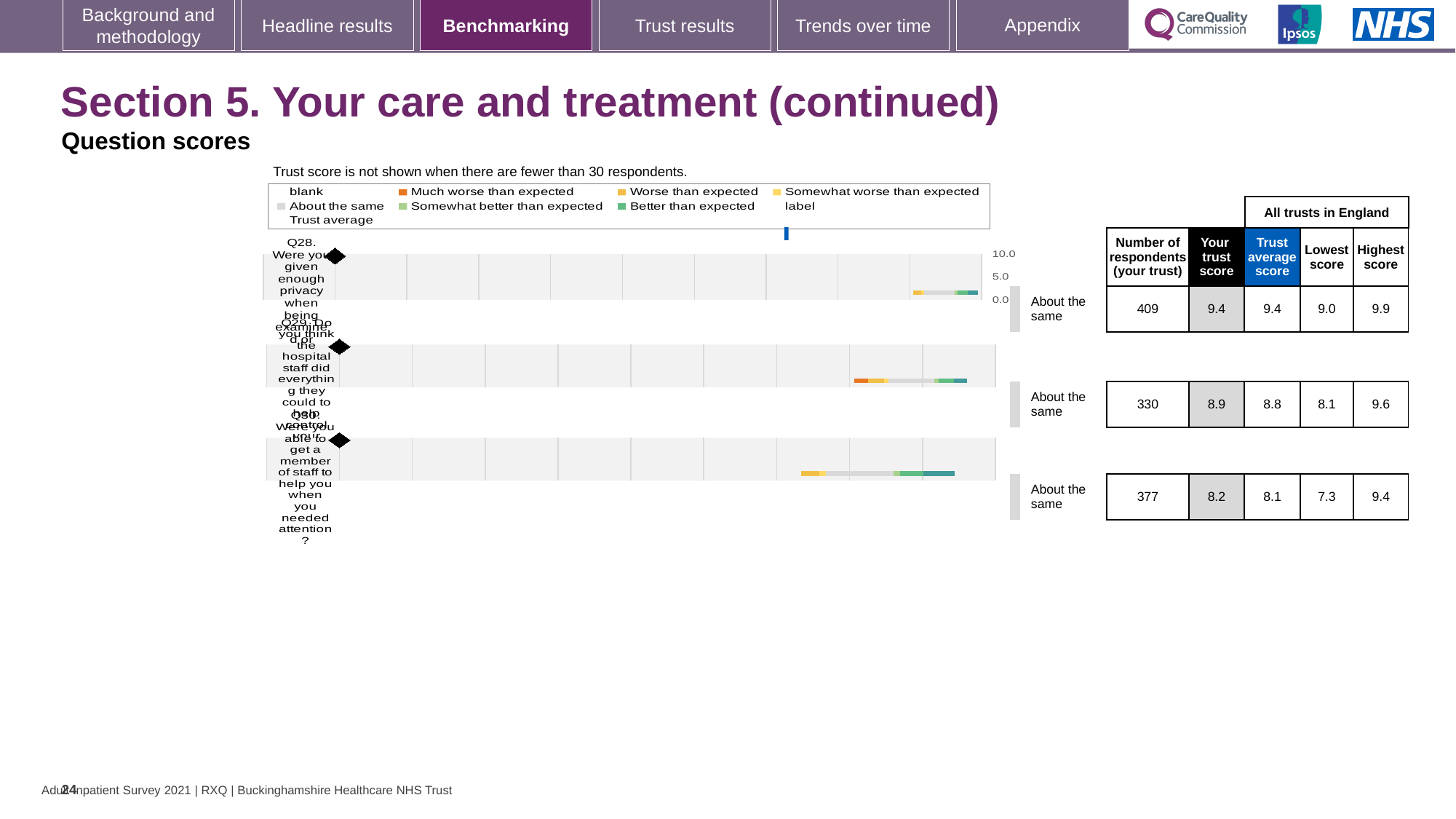
What is the difference between the highest and lowest scores for Q30? 2.1 What benchmark category is shown for Q30? About the same What is the lowest score across all trusts in England for Q28? 9.0 How many more respondents answered Q28 than Q30? 32 Which question has the fewest respondents? Q29 Which question has the highest trust score? Q28 What is the trust score for Q28 (privacy when being examined or treated)? 9.4 For Q29, which is larger: the trust score or the trust average score? Trust score What is the highest score across all trusts in England for Q30 (getting a member of staff to help when needed)? 9.4 What kind of chart is used to show the question scores? Bar chart How many questions are shown on the chart? 3 How many respondents answered Q29 (hospital staff did everything to help control pain)? 330